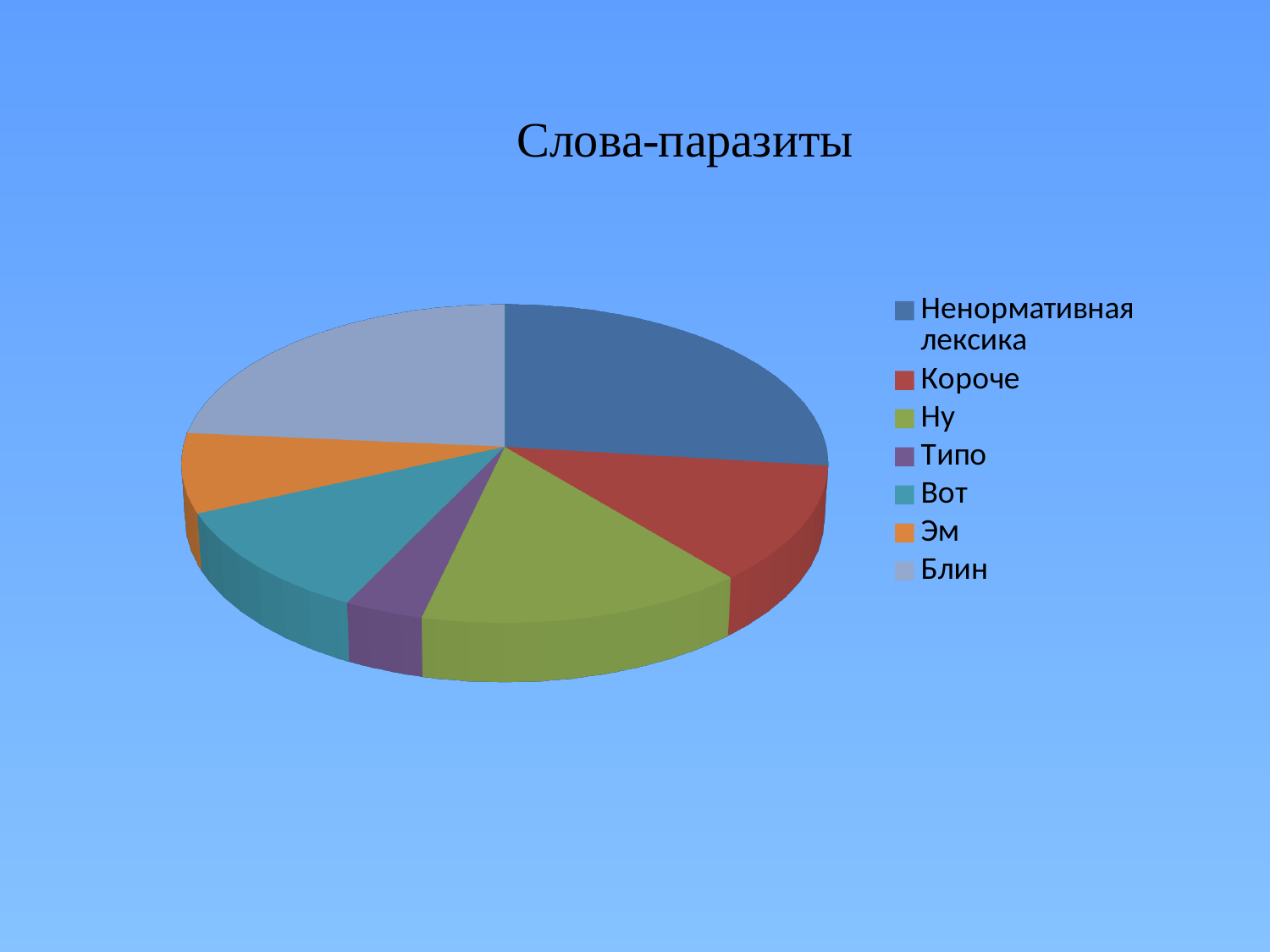
What colour is the slice for Короче? red How many entries does the legend list? 7 What kind of chart is shown on the slide? pie chart Which slice is larger, Вот or Типо? Вот How many categories (slices) does the pie chart have? 7 Which slice is larger, Ненормативная лексика or Короче? Ненормативная лексика What is the title of the chart? Слова-паразиты Which slice is larger, Ну or Типо? Ну Which category has the largest slice of the pie? Ненормативная лексика